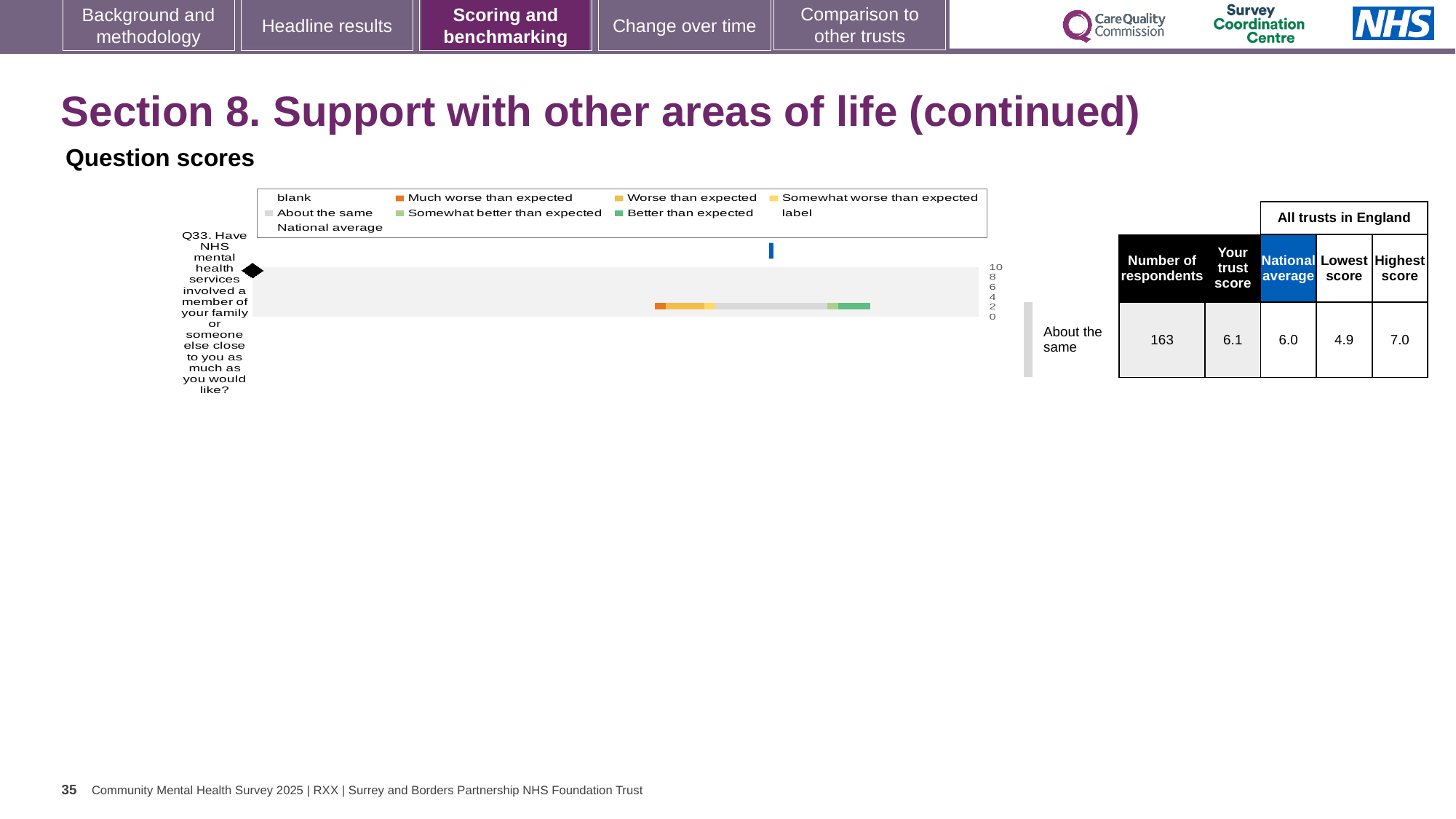
How many questions (categories) are plotted in the chart? 1 What kind of chart is shown on the slide? bar chart What is the difference between the highest and lowest scores among all trusts in England for Q33? 2.1 What is the lowest score among all trusts in England for Q33? 4.9 What is the trust's score for Q33? 6.1 What is the national average score for Q33? 6.0 How is the trust's result for Q33 categorised relative to expectations? About the same What is the difference between the trust's score and the national average for Q33? 0.1 Which is larger for Q33, the trust's score or the national average? the trust's score What is the number of respondents for Q33? 163 What is the highest score among all trusts in England for Q33? 7.0 Which question number is plotted in the chart? Q33